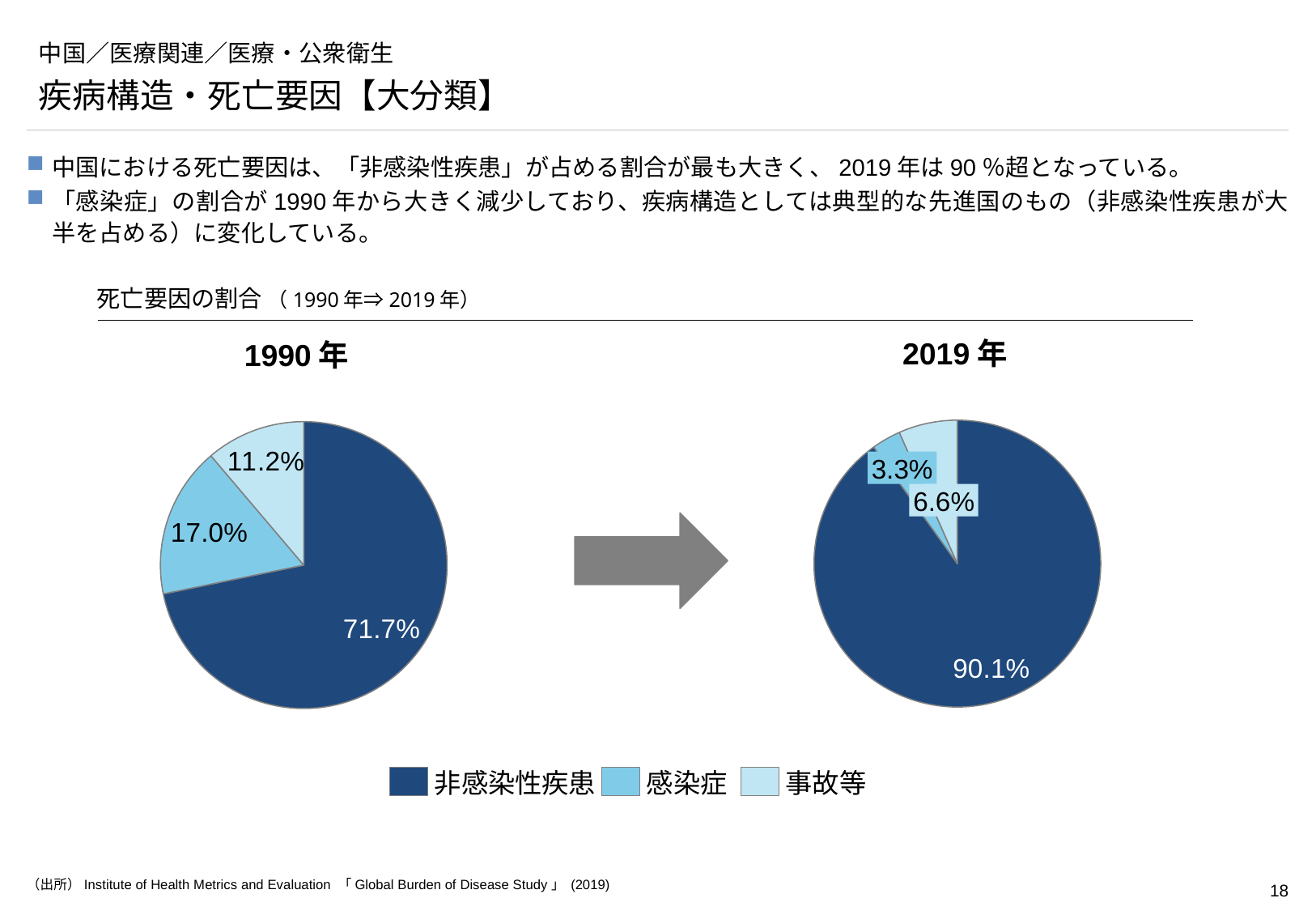
In the 1990年 pie chart, what is the share for 感染症? 17.0% In the 1990年 pie chart, which category has the largest share? 非感染性疾患 How many categories does the legend list? 3 In the 2019年 pie chart, what is the share for 感染症? 3.3% In the 2019年 pie chart, which category has the smallest share? 感染症 In the 1990年 pie chart, what is the share for 事故等? 11.2% In the 1990年 pie chart, what is the share for 非感染性疾患? 71.7% What is the difference between the 非感染性疾患 share in the 2019年 pie chart and in the 1990年 pie chart? 18.4 percentage points In the 2019年 pie chart, what is the share for 非感染性疾患? 90.1% In the 2019年 pie chart, what is the share for 事故等? 6.6% In the 1990年 pie chart, which is larger: the share for 感染症 or the share for 事故等? 感染症 What kind of charts are shown on the slide? Pie charts